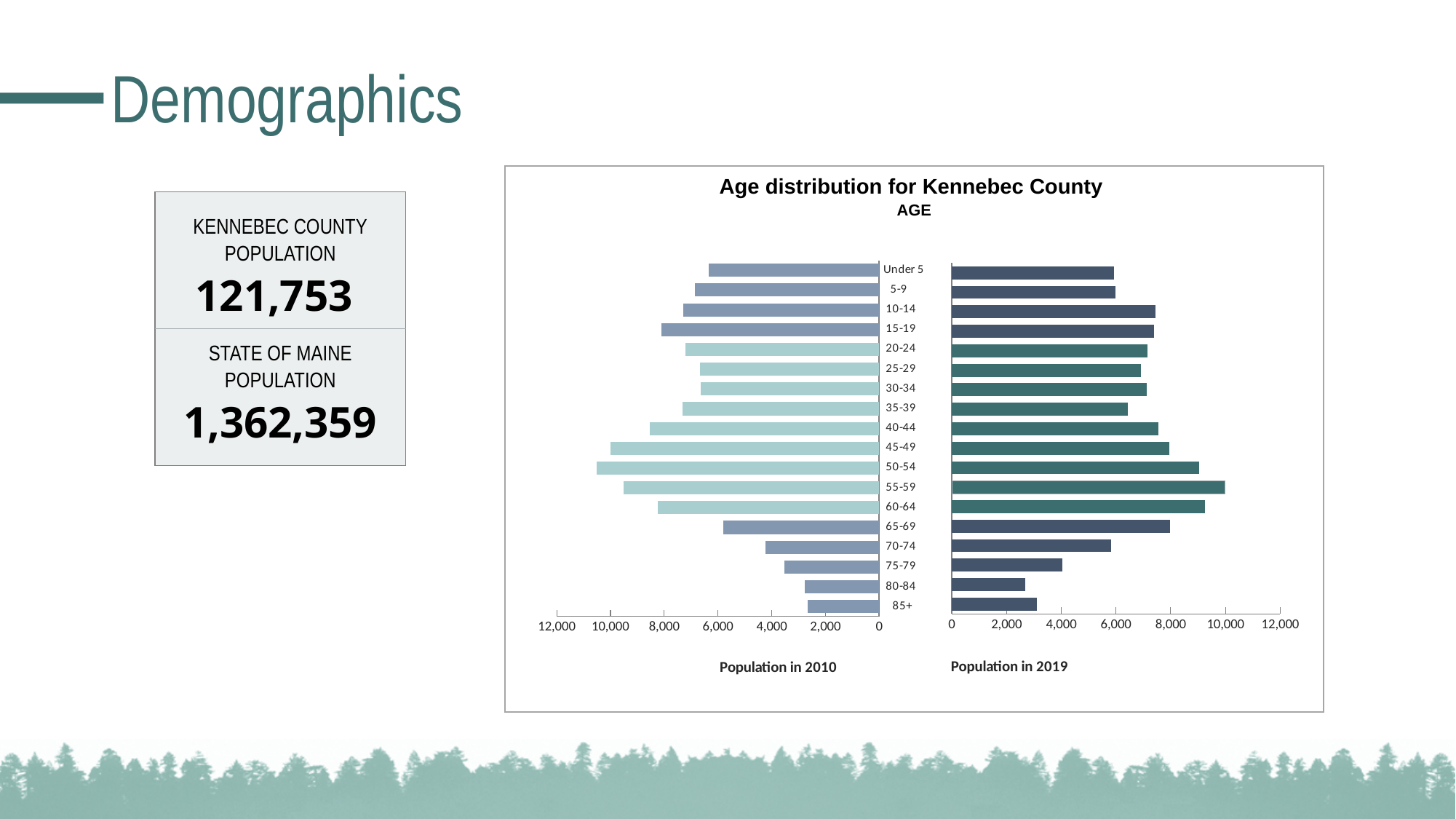
Which two years of population data does the chart compare? 2010 and 2019 What is the title of the chart? Age distribution for Kennebec County Which age group has the lowest population in 2019? 80-84 In 2019, which age group has the larger population: 55-59 or Under 5? 55-59 Is the 2019 population for the 55-59 age group greater or less than 8,000? greater What kind of chart is shown on the slide? bar chart Which age group has the highest population in 2019? 55-59 In 2010, which age group has the larger population: 50-54 or 70-74? 50-54 Is the 2019 population for the 80-84 age group greater or less than 4,000? less How many age groups are plotted in the chart? 18 Is the 2010 population for the Under 5 age group greater or less than 8,000? less